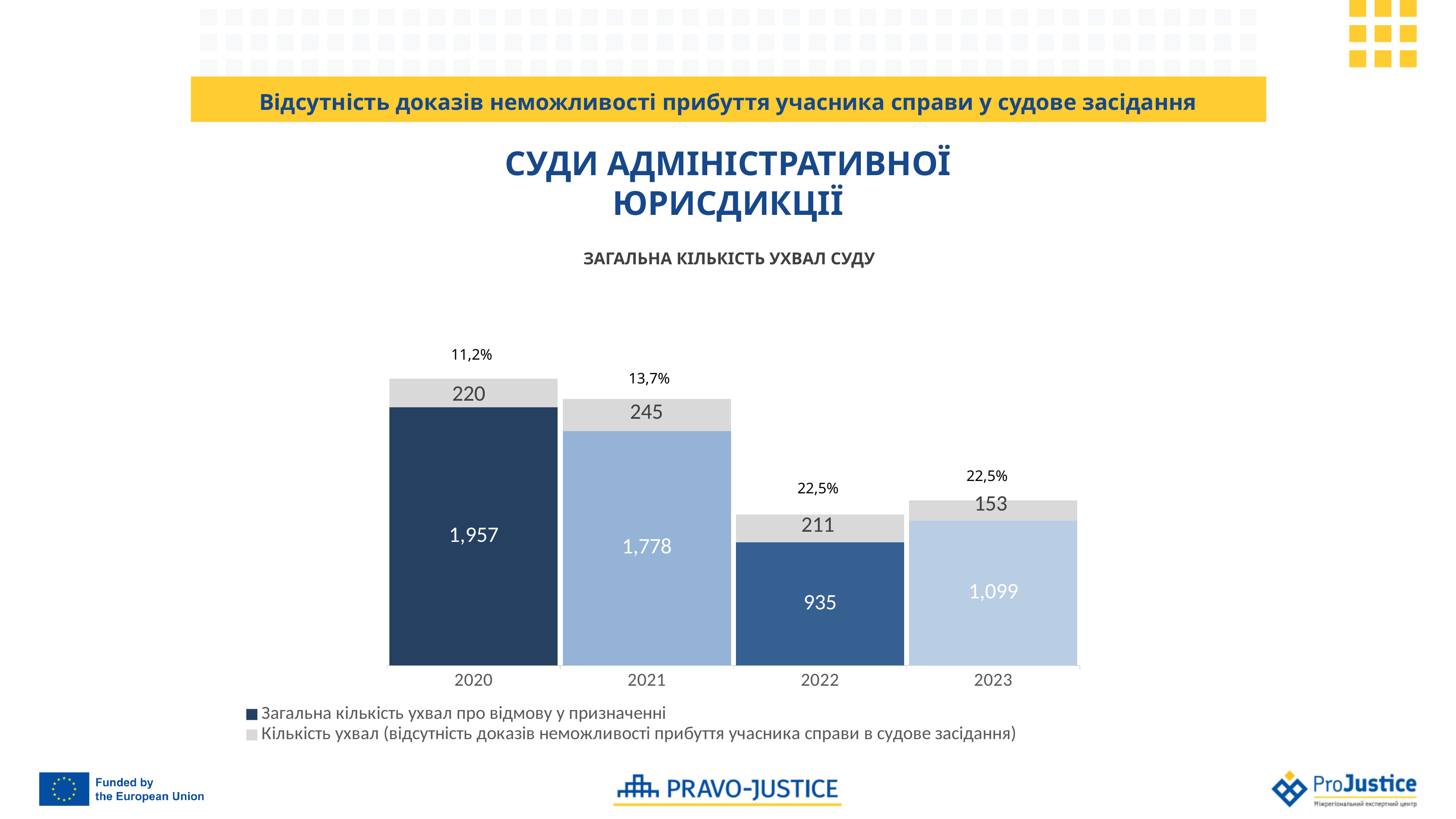
What is the difference between the 'Загальна кількість ухвал про відмову у призначенні' values for 2020 and 2021? 179 Which is larger: the 'Загальна кількість ухвал про відмову у призначенні' value for 2022 or for 2023? 2023 What is the value of the 'Загальна кількість ухвал про відмову у призначенні' series for 2020? 1,957 What type of chart is shown on the slide? Stacked bar chart Which year has the highest value for the 'Загальна кількість ухвал про відмову у призначенні' series? 2020 What percentage is shown above the bar for 2022? 22,5% What is the value of the 'Загальна кількість ухвал про відмову у призначенні' series for 2023? 1,099 How many series does the legend list? 2 How many years are shown on the x axis? 4 Which year has the lowest value for the 'Кількість ухвал (відсутність доказів неможливості прибуття учасника справи в судове засідання)' series? 2023 What is the total of the stacked bar for 2022? 1,146 What is the value of the 'Кількість ухвал (відсутність доказів неможливості прибуття учасника справи в судове засідання)' series for 2021? 245